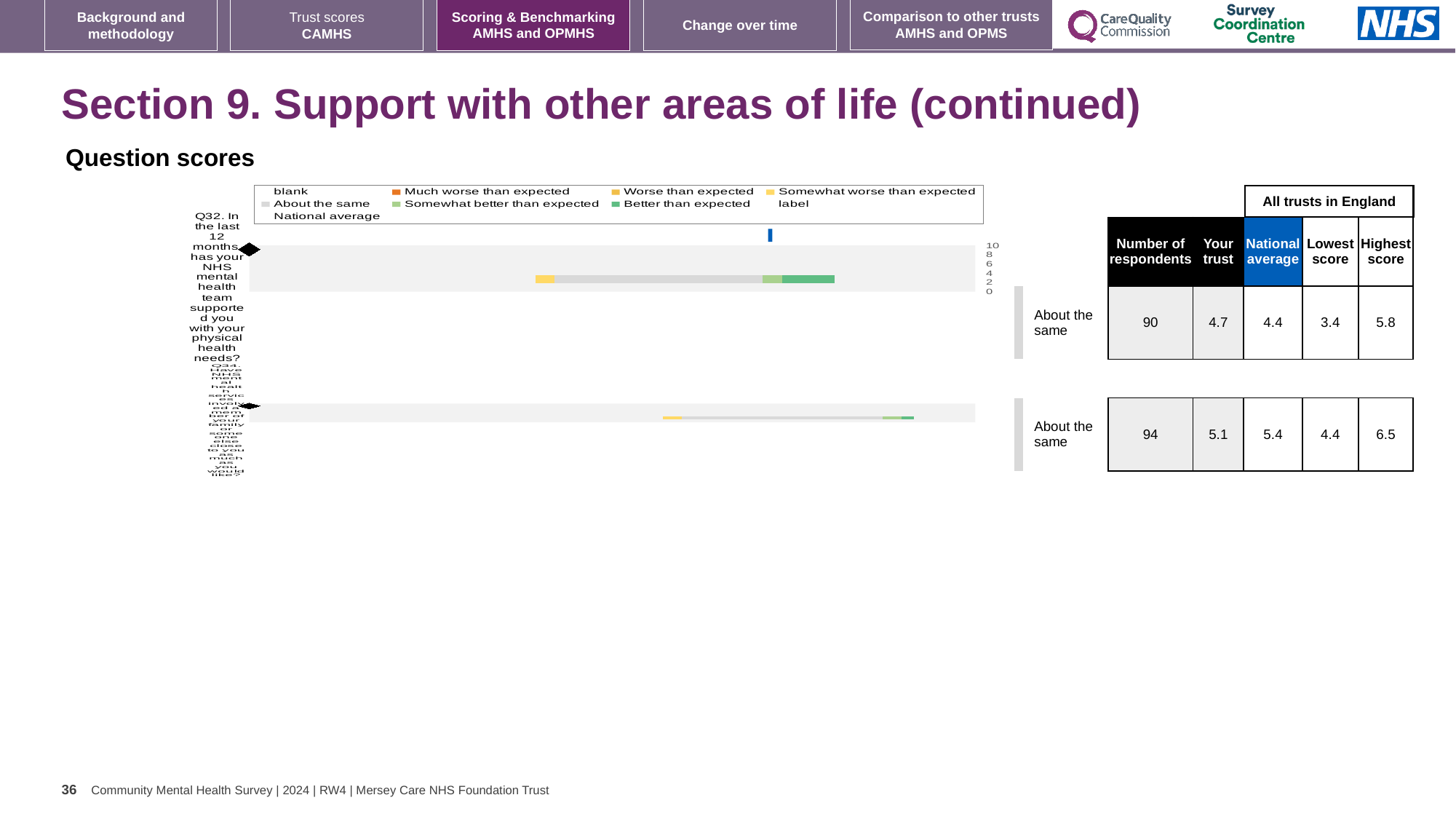
What is the national average score for Q34 (involving family or someone close)? 5.4 What is the difference between the highest and lowest scores for Q32? 2.4 For Q34, which is higher: the 'Your trust' score or the national average? National average What is the 'Your trust' score for Q32 (support with physical health needs)? 4.7 What is the difference between the highest and lowest scores for Q34? 2.1 How many survey questions are plotted in the question scores chart? 2 For Q32, which is higher: the 'Your trust' score or the national average? Your trust What benchmark category is shown for both Q32 and Q34? About the same What kind of chart is used to show the question scores on this slide? bar chart What colour represents 'Better than expected' in the chart legend? Green How many respondents answered Q32? 90 What is the highest score among all trusts in England for Q34? 6.5